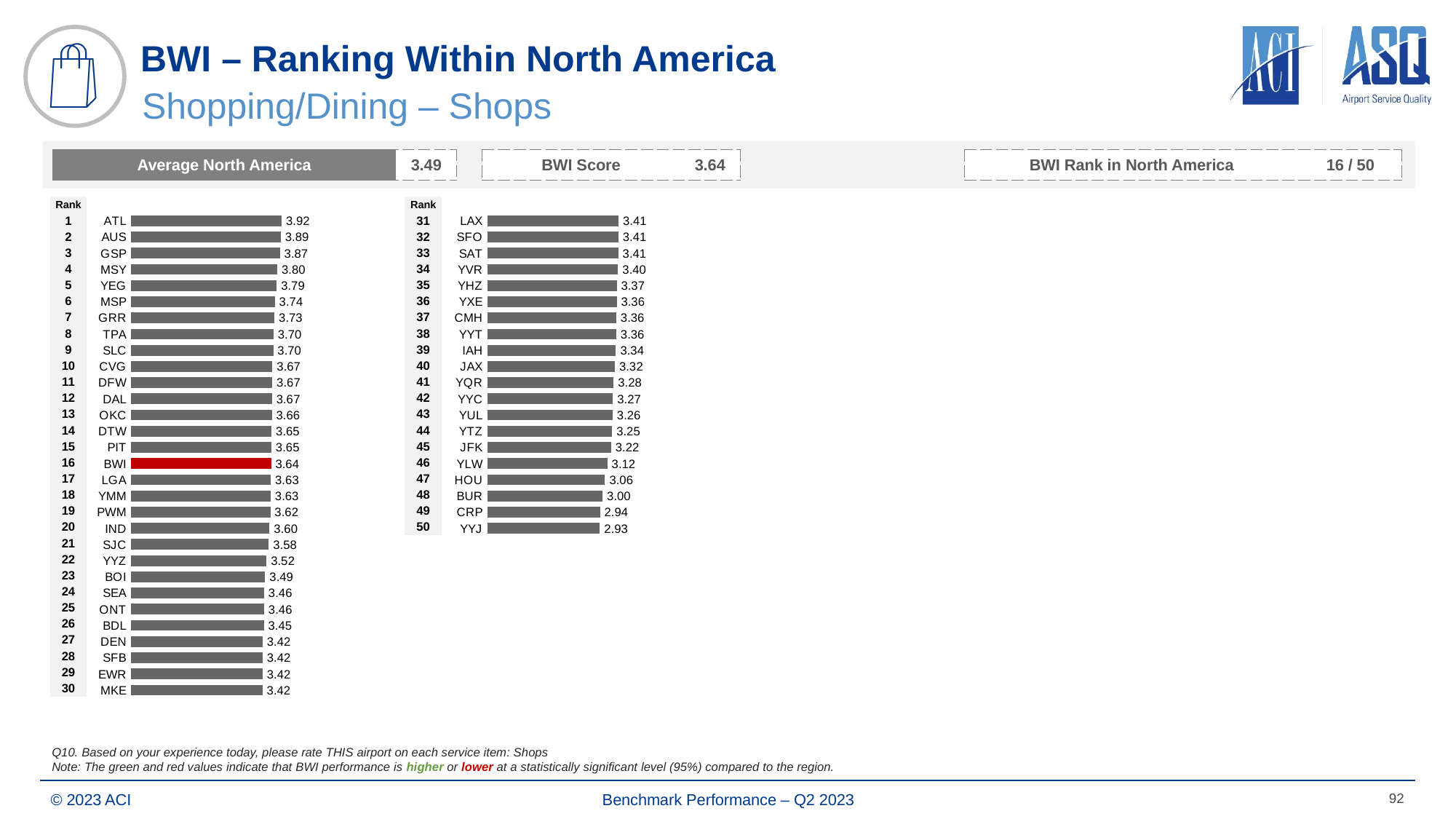
What is the score for BWI in the ranking chart? 3.64 What is BWI's rank in North America according to the slide? 16 / 50 Which airport has the lowest score in the ranking chart? YYJ Which has a higher score, DEN or HOU? DEN What is the Average North America score shown on the slide? 3.49 What is the score for ATL in the ranking chart? 3.92 What is the score for YYJ in the ranking chart? 2.93 Which airport has the highest score in the ranking chart? ATL What kind of chart is used to show the airport rankings? Bar chart What is the difference between the scores of ATL and BWI? 0.28 Which airport's bar is highlighted in red in the ranking chart? BWI How many airports are ranked in the chart? 50